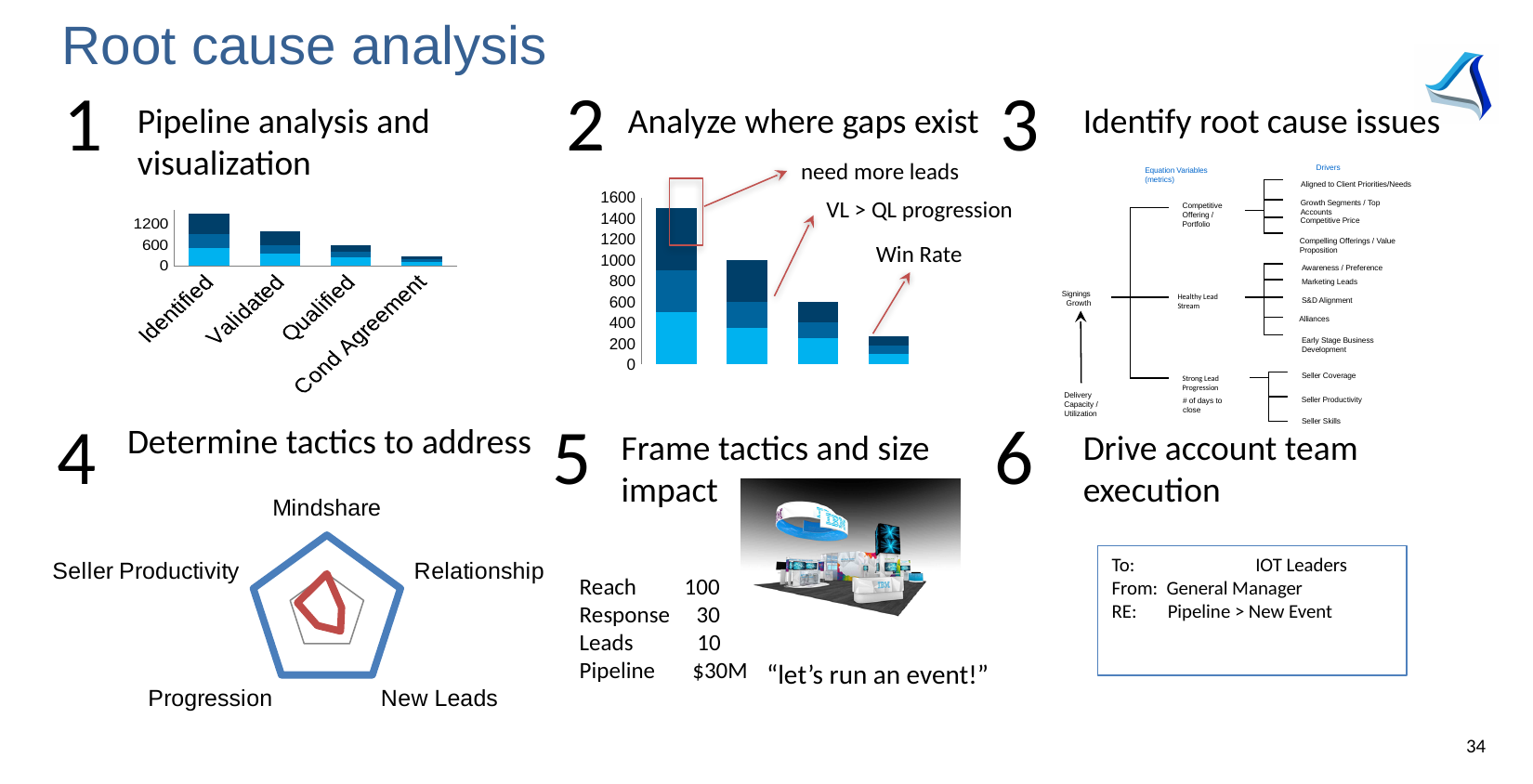
In the 'Pipeline analysis and visualization' chart (section 1), how many categories are shown on the x axis? 4 In the 'Pipeline analysis and visualization' chart (section 1), which category has the shortest bar? Cond Agreement In the 'Analyze where gaps exist' chart (section 2), is the total of the rightmost bar greater or less than 400? less In the 'Pipeline analysis and visualization' chart (section 1), is the total value for Cond Agreement greater or less than 600? less In the 'Pipeline analysis and visualization' chart (section 1), what kind of chart is shown? bar chart In the 'Pipeline analysis and visualization' chart (section 1), which category has the tallest bar? Identified In the 'Determine tactics to address' chart (section 4), how many axes does the radar chart have? 5 In the 'Analyze where gaps exist' chart (section 2), is the total of the leftmost bar greater or less than 1400? greater In the 'Analyze where gaps exist' chart (section 2), how many bars are plotted? 4 In the 'Pipeline analysis and visualization' chart (section 1), do the bar totals rise or fall from left to right along the x axis? fall In the 'Pipeline analysis and visualization' chart (section 1), which bar is taller, Identified or Validated? Identified